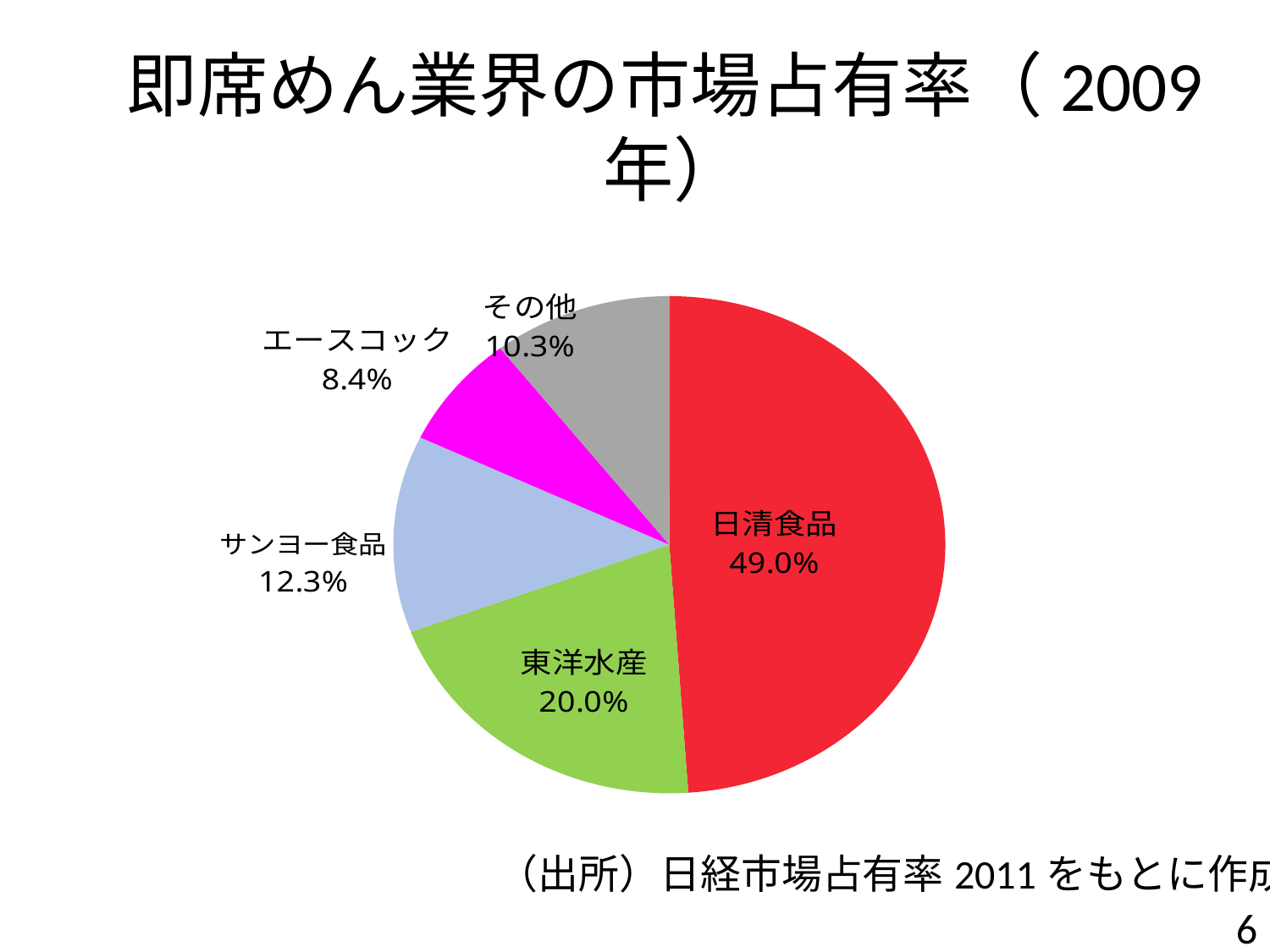
What is the difference between the shares of 日清食品 and 東洋水産? 29.0% How many slices does the pie chart have? 5 What is the market share of 東洋水産? 20.0% What colour is the 東洋水産 slice? Green What is the market share of エースコック? 8.4% What is the market share of 日清食品? 49.0% Which company has the largest market share? 日清食品 What kind of chart is shown on the slide? Pie chart What is the market share of サンヨー食品? 12.3% Which slice is the smallest? エースコック What is the share of その他? 10.3% Which has a larger share, サンヨー食品 or その他? サンヨー食品